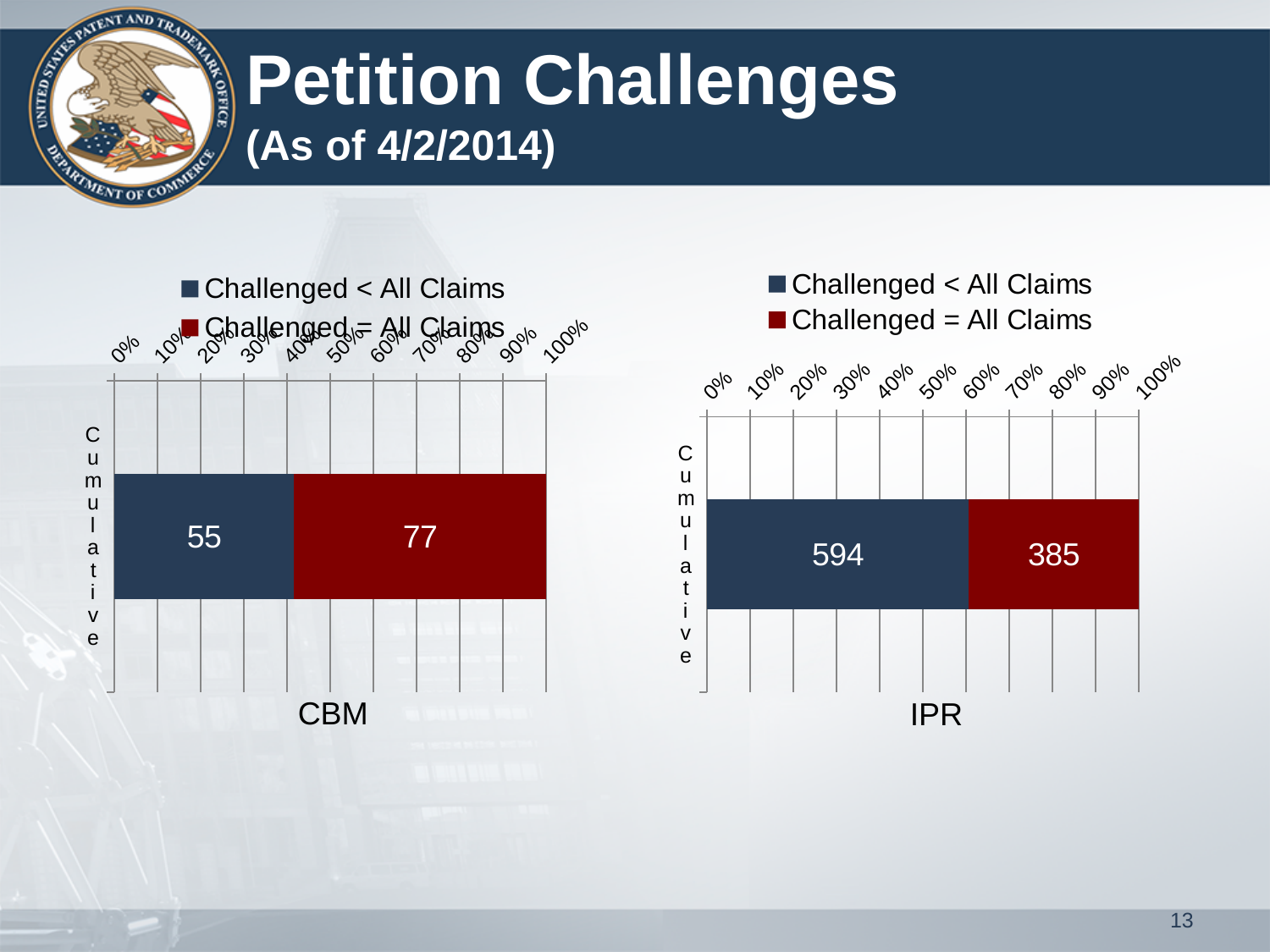
In the IPR chart on the right, which series has the larger value, "Challenged < All Claims" or "Challenged = All Claims"? Challenged < All Claims How many series does the legend of the IPR chart on the right list? 2 In the IPR chart on the right, what is the difference between the "Challenged < All Claims" value and the "Challenged = All Claims" value? 209 In the CBM chart on the left, what is the value for "Challenged < All Claims"? 55 In the CBM chart on the left, what is the total of the two segments in the stacked bar? 132 In the CBM chart on the left, what is the difference between the "Challenged = All Claims" value and the "Challenged < All Claims" value? 22 What kind of chart is the CBM chart on the left? Stacked bar chart In the IPR chart on the right, what is the value for "Challenged = All Claims"? 385 In the IPR chart on the right, what is the total of the two segments in the stacked bar? 979 In the CBM chart on the left, which series has the larger value, "Challenged < All Claims" or "Challenged = All Claims"? Challenged = All Claims In the CBM chart on the left, what is the value for "Challenged = All Claims"? 77 In the IPR chart on the right, what is the value for "Challenged < All Claims"? 594